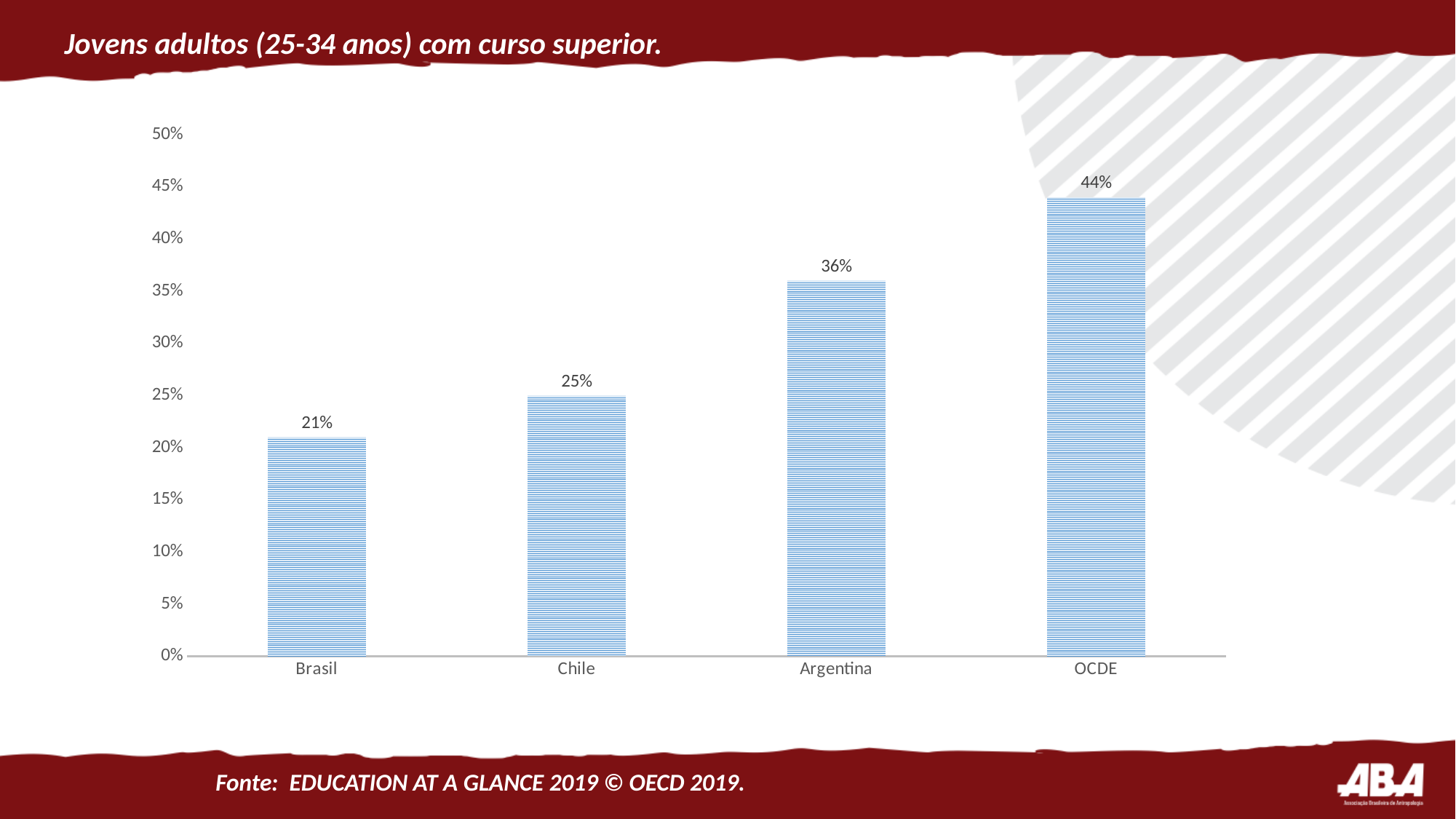
What is the value for OCDE? 44% Which is larger, the value for Chile or the value for Argentina? Argentina What is the value for Brasil? 21% What is the difference between the values for Argentina and Chile? 11% Which category has the highest value? OCDE What is the difference between the values for OCDE and Brasil? 23% What is the value for Chile? 25% Which category has the lowest value? Brasil What kind of chart is shown on the slide? Bar chart Do the values rise or fall from left to right along the x axis? Rise What is the value for Argentina? 36% How many categories are shown on the x axis? 4